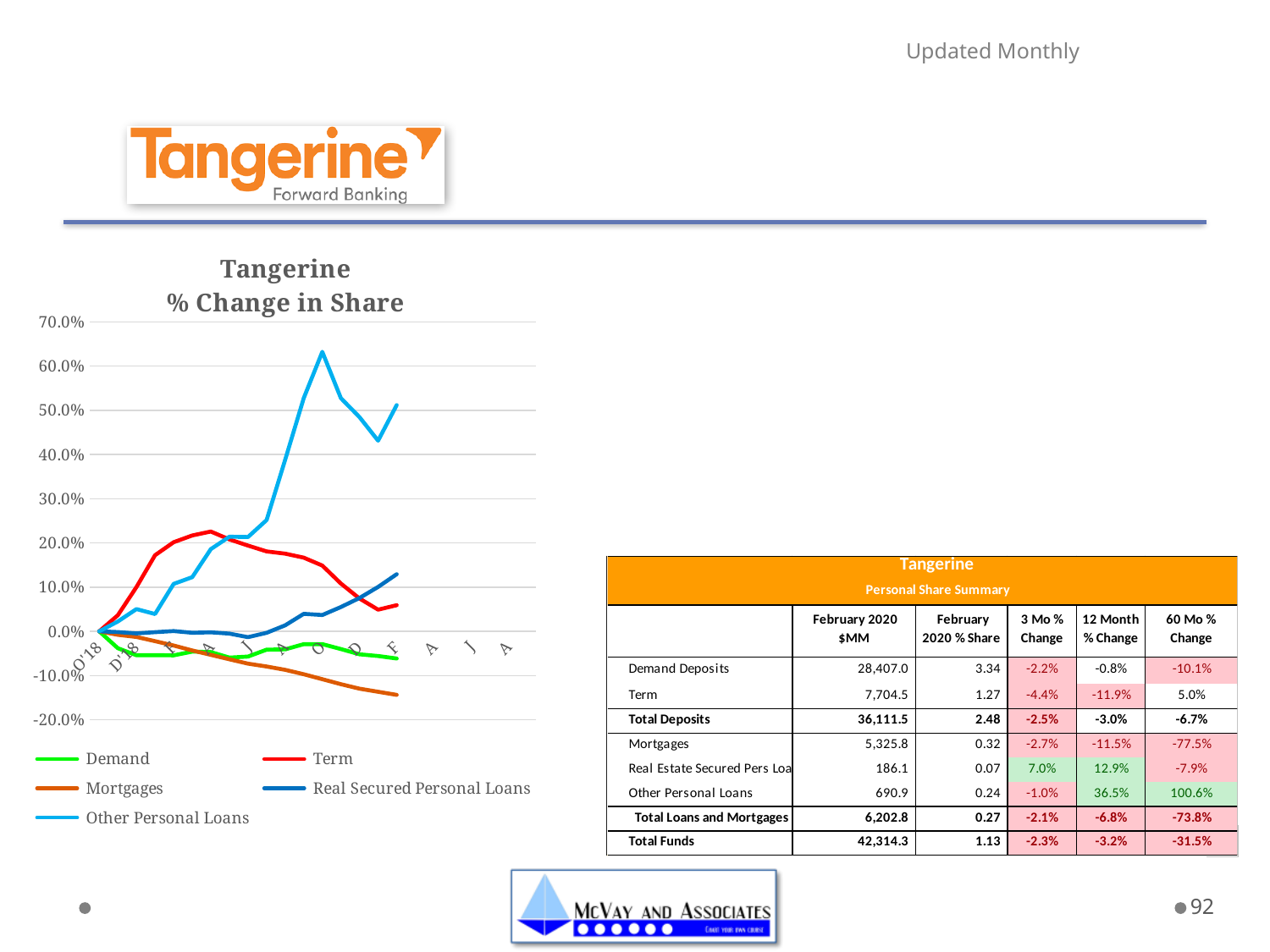
In the '% Change in Share' chart, is the final value of Mortgages greater or less than -10.0%? less Does the Other Personal Loans line in the '% Change in Share' chart rise or fall overall from the start to the end of the x axis? rise How many series does the legend of the '% Change in Share' chart list? 5 What kind of chart is the 'Tangerine % Change in Share' chart? line chart What colour is the Term line in the '% Change in Share' chart? red Does the Mortgages line in the '% Change in Share' chart rise or fall along the x axis? fall In the '% Change in Share' chart, is the peak value of Other Personal Loans greater or less than 50.0%? greater Which series in the '% Change in Share' chart reaches the highest value? Other Personal Loans In the '% Change in Share' chart, is the peak value of Term greater or less than 10.0%? greater In the '% Change in Share' chart, which is larger at the right end of the x axis: Real Secured Personal Loans or Demand? Real Secured Personal Loans What is the highest value shown on the y axis of the '% Change in Share' chart? 70.0% Which series in the '% Change in Share' chart ends at the lowest value at the right end of the x axis? Mortgages